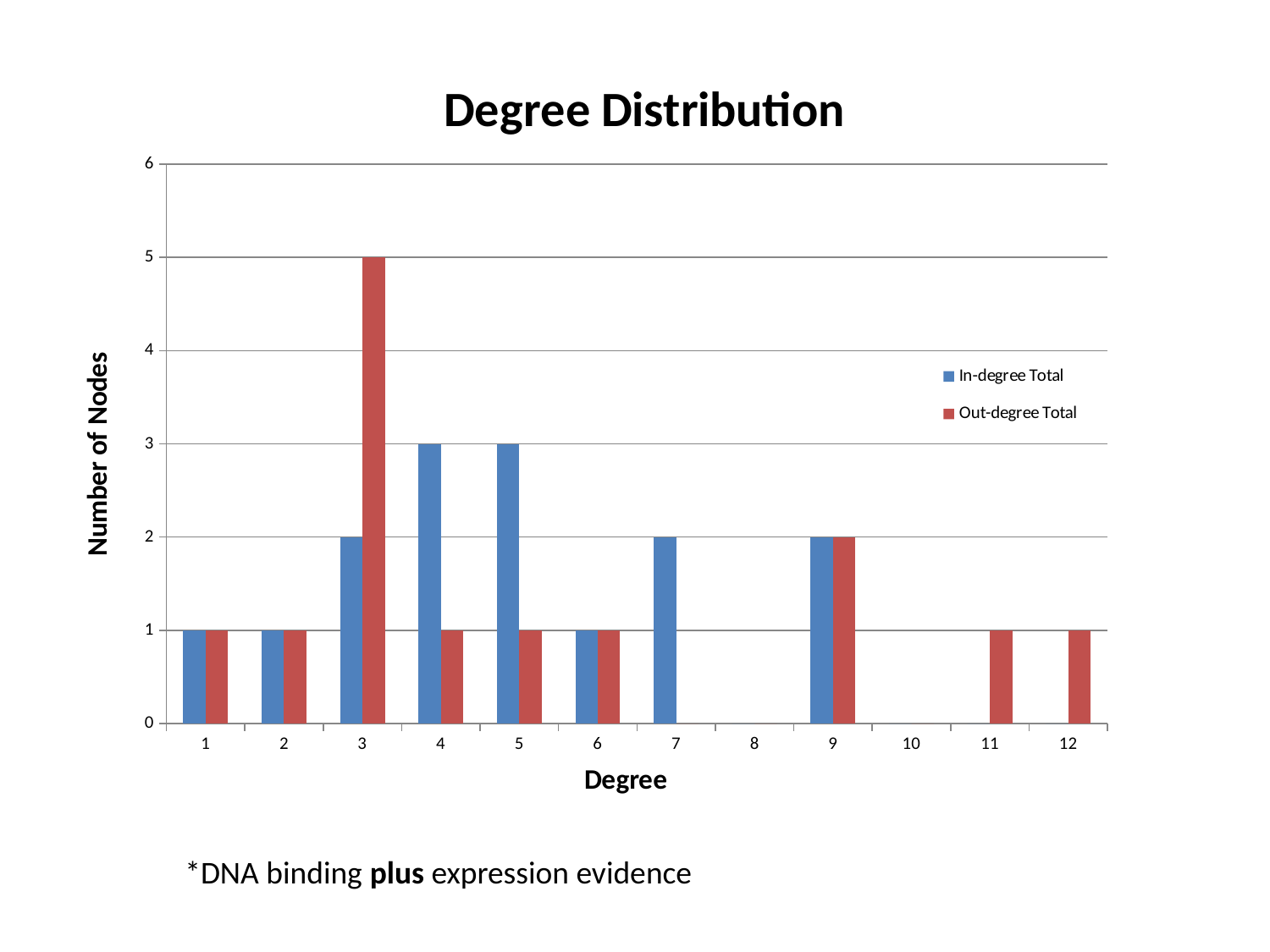
What is the difference between the Out-degree Total and the In-degree Total at degree 3? 3 What is the title of the chart? Degree Distribution Which degree has the highest Out-degree Total? 3 What is the In-degree Total for degree 7? 2 What is the Out-degree Total for degree 3? 5 What is the Out-degree Total for degree 11? 1 How many series does the legend list? 2 At degree 5, which is larger, the In-degree Total or the Out-degree Total? In-degree Total How many degree categories are shown on the x axis? 12 What type of chart is shown on the slide? bar chart Is the Out-degree Total for degree 3 greater or less than 4? greater What is the In-degree Total for degree 4? 3